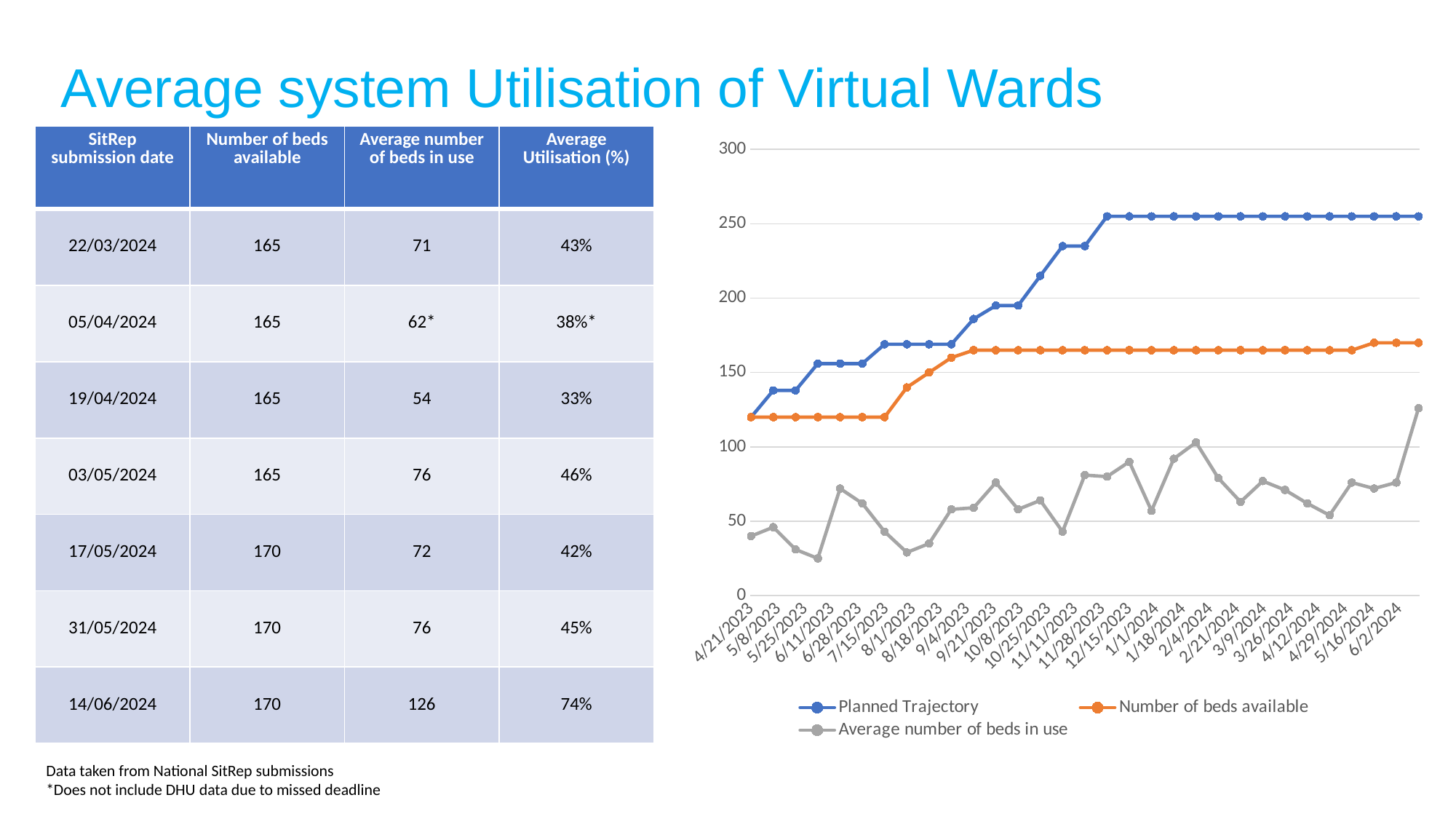
At 6/2/2024, which is larger: Planned Trajectory or Number of beds available? Planned Trajectory Does the Planned Trajectory series rise or fall from 4/21/2023 to 6/2/2024? rise What kind of chart is shown on the slide? line chart What colour is the Planned Trajectory line in the chart? blue How many series does the chart legend list? 3 Is the Number of beds available value at 4/21/2023 greater or less than 150? less Is the Number of beds available value at 6/2/2024 greater or less than 150? greater Which series has the lowest values across the chart? Average number of beds in use Is the Average number of beds in use value at 8/1/2023 greater or less than 50? less Which series reaches the highest value on the chart? Planned Trajectory